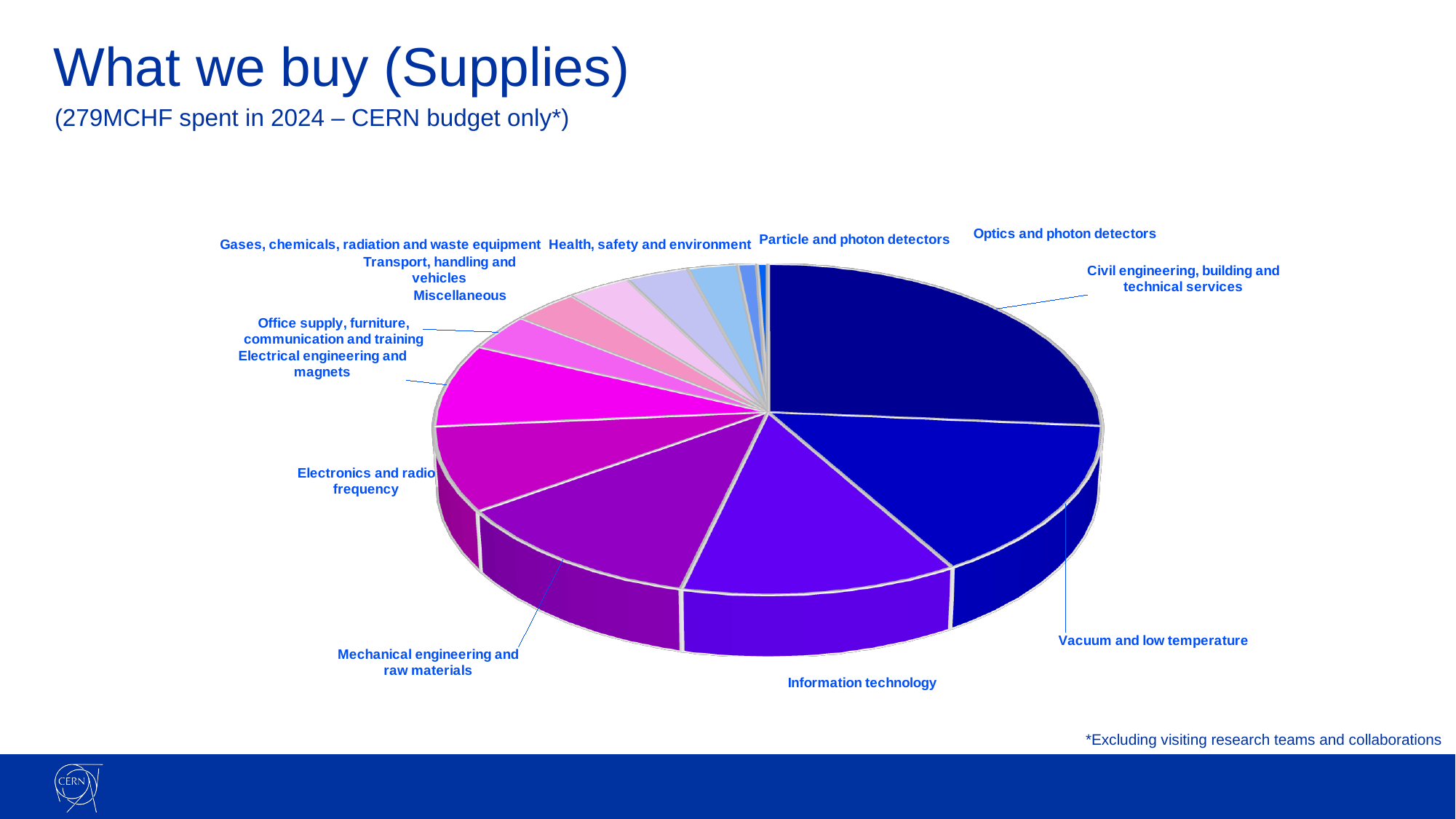
What is the title of the slide containing the pie chart? What we buy (Supplies) Which slice is larger: Vacuum and low temperature or Health, safety and environment? Vacuum and low temperature How many categories (slices) does the pie chart show? 13 Which slice is larger: Mechanical engineering and raw materials or Electronics and radio frequency? Mechanical engineering and raw materials Which category has the largest slice of the pie chart? Civil engineering, building and technical services What kind of chart is shown on the slide? pie chart Which category has the smallest slice of the pie chart? Optics and photon detectors Which slice is larger: Electrical engineering and magnets or Office supply, furniture, communication and training? Electrical engineering and magnets According to the subtitle, how much was spent in 2024 on supplies from the CERN budget? 279MCHF